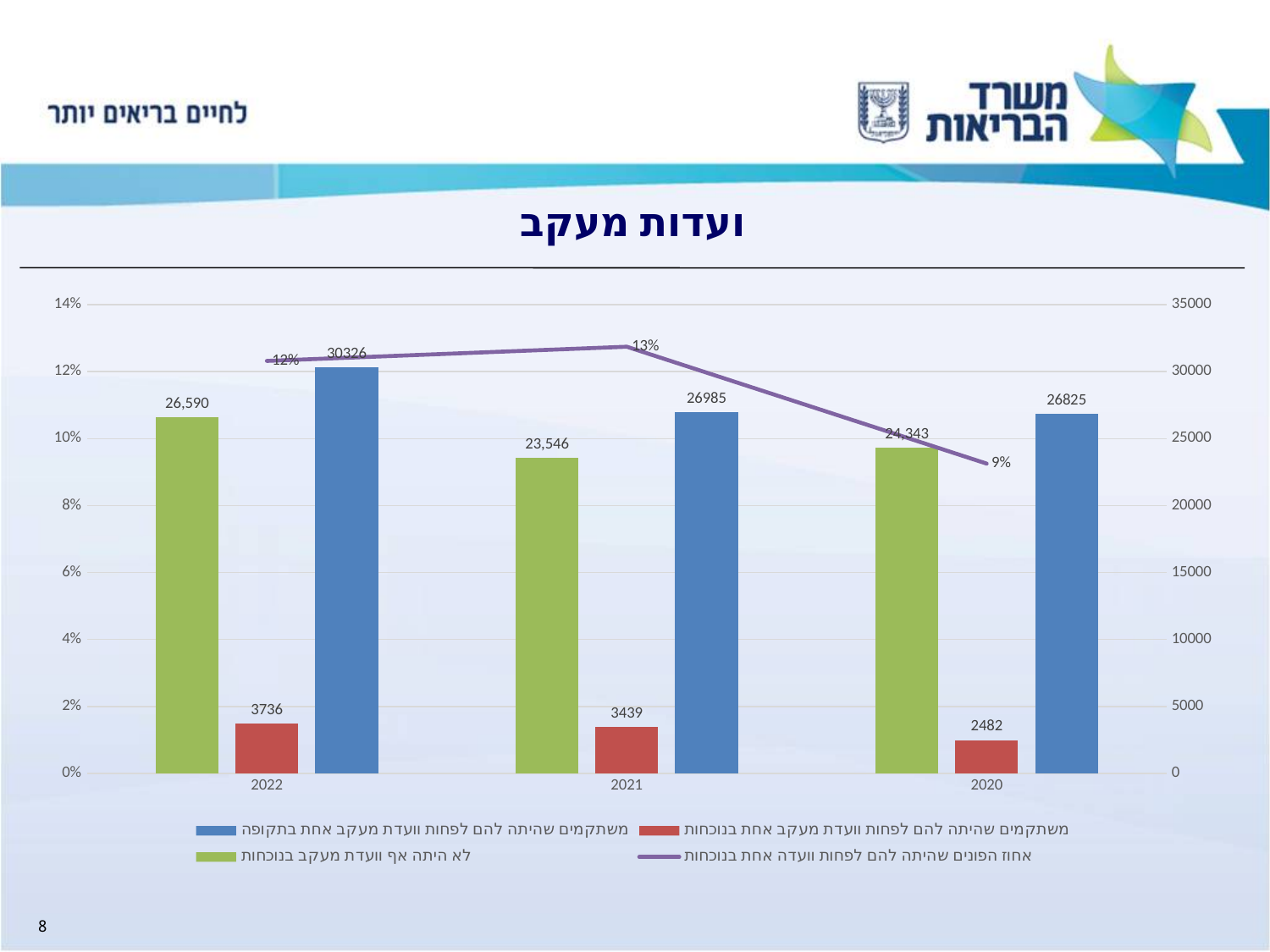
What is the value of the red bar (משתקמים שהיתה להם לפחות ועדת מעקב אחת בנוכחות) for 2020? 2482 Which is larger: the green bar for 2020 or the green bar for 2021? 2020 In which year is the blue bar (משתקמים שהיתה להם לפחות ועדת מעקב אחת בתקופה) highest? 2022 In which year is the red bar (משתקמים שהיתה להם לפחות ועדת מעקב אחת בנוכחות) lowest? 2020 How many years are shown on the x axis? 3 What is the value of the blue bar (משתקמים שהיתה להם לפחות ועדת מעקב אחת בתקופה) for 2022? 30326 What is the difference between the red bar values for 2022 and 2021? 297 Is the blue bar for 2021 greater or less than 25000 on the right axis? greater What is the value of the green bar (לא היתה אף ועדת מעקב בנוכחות) for 2021? 23,546 What is the title of the chart? ועדות מעקב How many series does the legend list? 4 What percentage does the purple line (אחוז הפונים שהיתה להם לפחות ועדה אחת בנוכחות) show for 2021? 13%